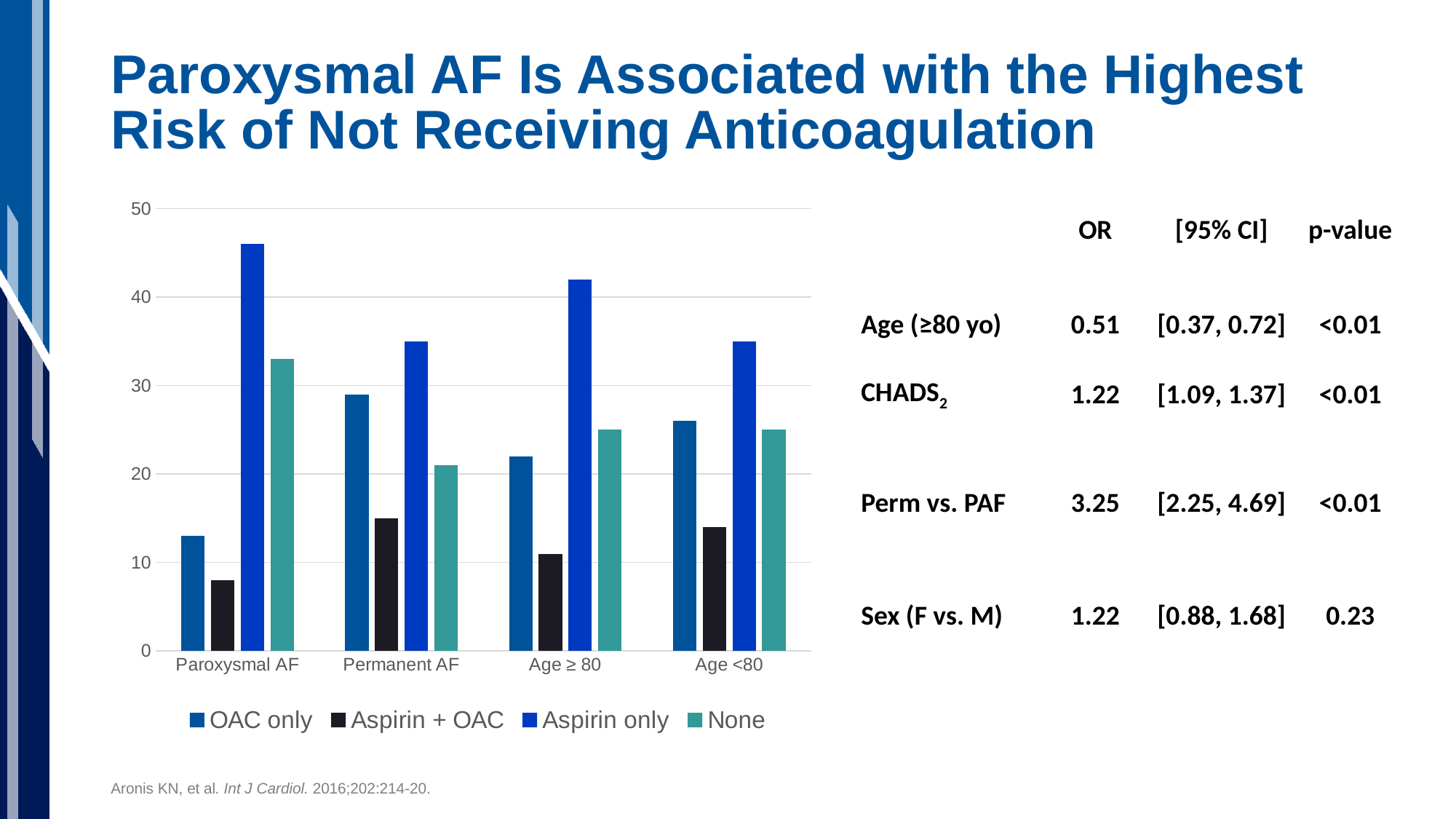
Which is larger: the 'None' value for Paroxysmal AF or for Permanent AF? Paroxysmal AF Is the 'Aspirin only' value for Paroxysmal AF greater or less than 40? greater Is the 'None' value for Permanent AF greater or less than 30? less Which category has the highest 'Aspirin only' bar? Paroxysmal AF Which is larger: the 'OAC only' value for Permanent AF or for Age ≥ 80? Permanent AF Which category has the lowest 'Aspirin + OAC' bar? Paroxysmal AF Within the Paroxysmal AF category, which series has the tallest bar? Aspirin only How many categories are shown on the x axis of the chart? 4 What kind of chart is shown on the slide? Bar chart How many series does the chart's legend list? 4 Is the 'OAC only' value for Paroxysmal AF greater or less than 20? less What are the four series listed in the chart's legend? OAC only, Aspirin + OAC, Aspirin only, None